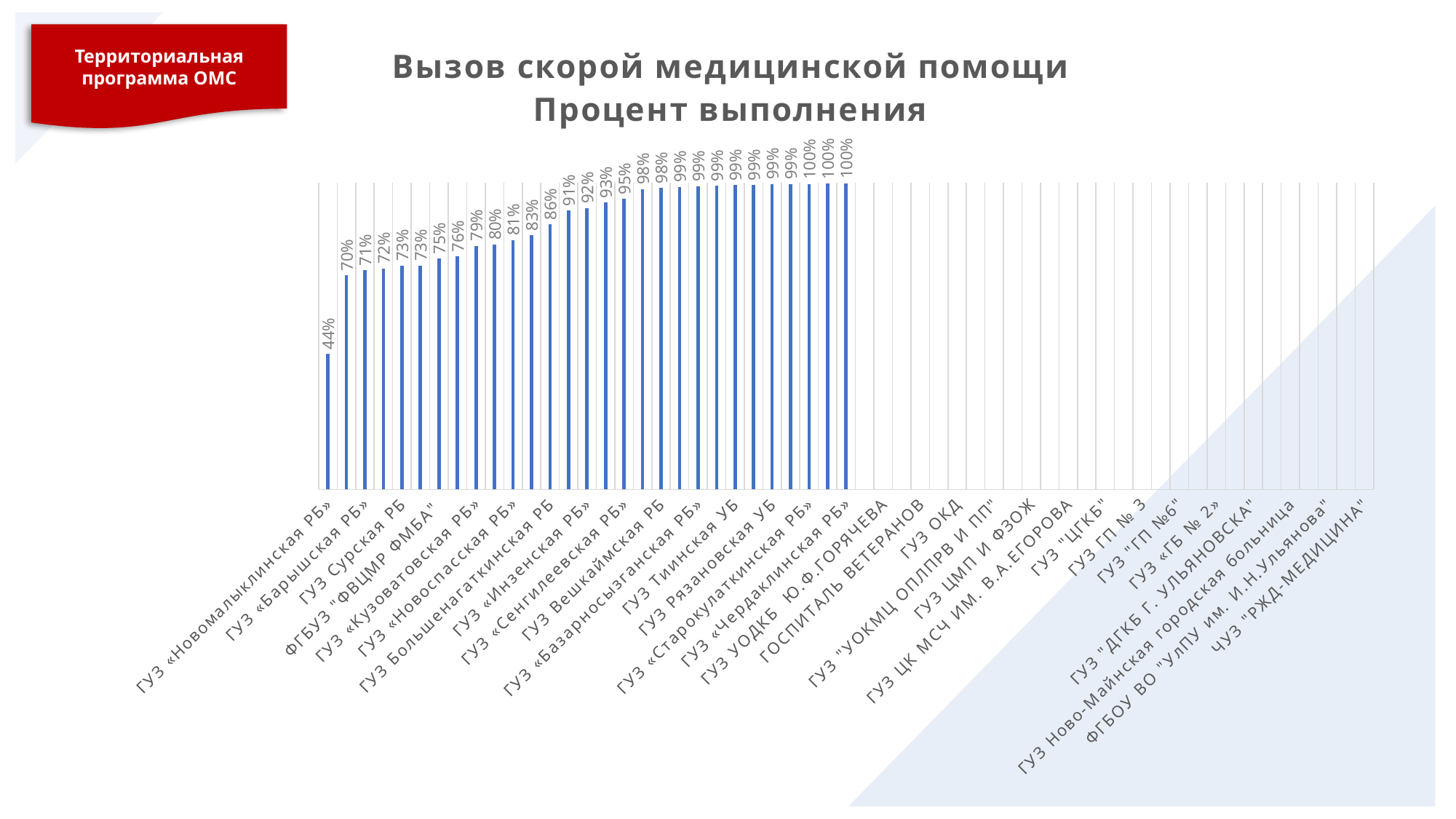
What is the value for ГУЗ Сурская РБ? 73% What is the value of the lowest bar in the chart? 44% What is the difference between the highest value (100%) and the lowest value (44%)? 56% How many bars have a value of 100%? 3 How many bars (categories) are plotted in the chart? 29 What is the highest value shown in the chart? 100% What is the title of the chart? Вызов скорой медицинской помощи Процент выполнения What is the value for ГУЗ «Барышская РБ»? 71% What kind of chart is shown on the slide? bar chart Do the values rise or fall from left to right along the x axis? rise Which category has the lowest value in the chart? ГУЗ «Новомалыклинская РБ»